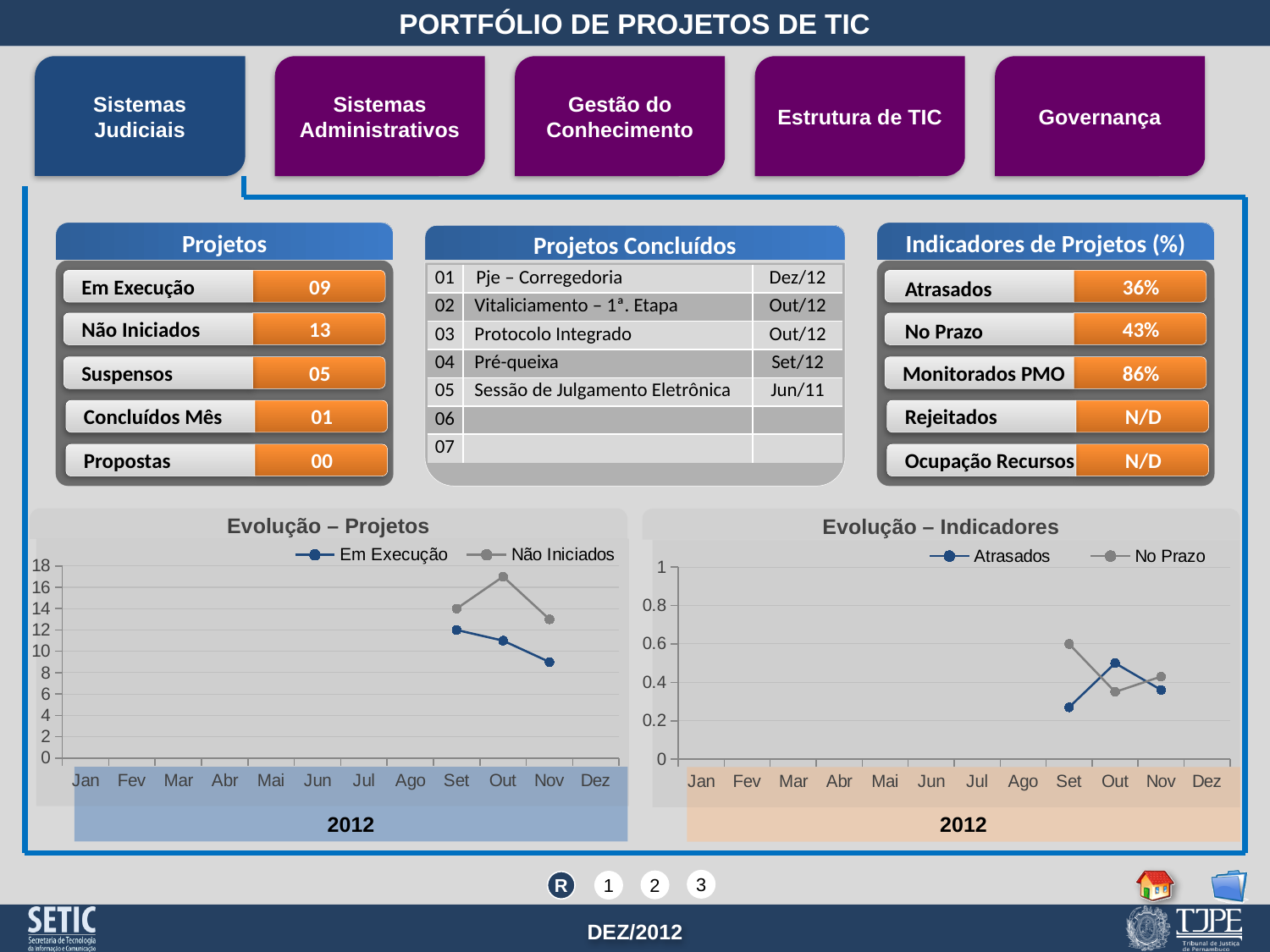
In the "Evolução – Projetos" chart, does the Em Execução series rise or fall from Set to Nov? fall How many series does the legend of the "Evolução – Indicadores" chart list? 2 In the "Evolução – Projetos" chart, which series has the larger value in Set, Em Execução or Não Iniciados? Não Iniciados In the "Evolução – Indicadores" chart, is the value for Atrasados in Out greater or less than 0.4? greater In the "Evolução – Projetos" chart, is the value for Não Iniciados in Out greater or less than 16? greater In the "Evolução – Projetos" chart, which two series are listed in the legend? Em Execução and Não Iniciados In the "Evolução – Indicadores" chart, which series has the larger value in Set, Atrasados or No Prazo? No Prazo In the "Evolução – Indicadores" chart, is the value for No Prazo in Set greater or less than 0.4? greater In the "Evolução – Projetos" chart, in which month does Não Iniciados reach its highest value? Out What kind of chart is the "Evolução – Projetos" chart? line chart In the "Evolução – Indicadores" chart, how many months have plotted data points? 3